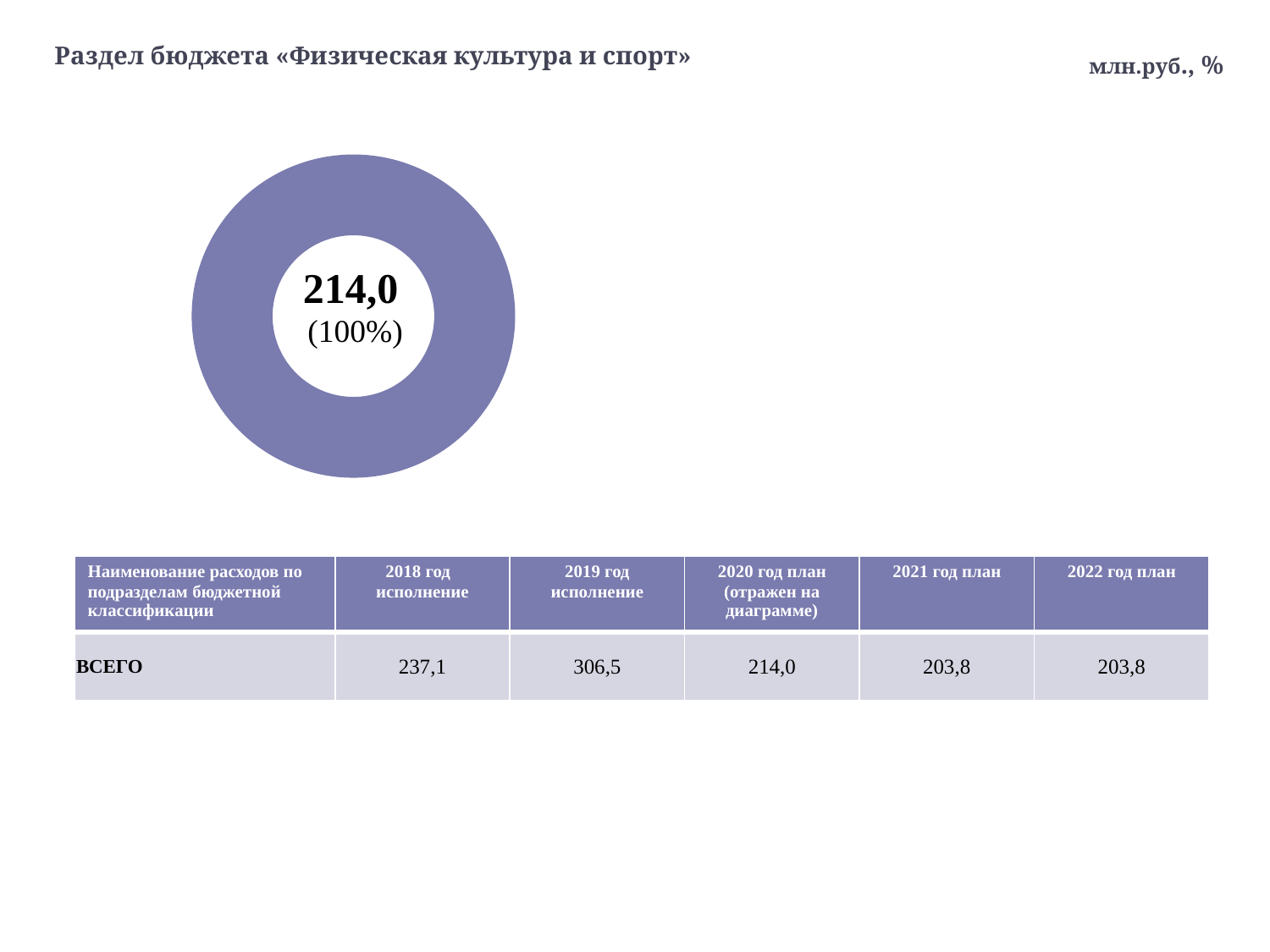
What kind of chart is shown on the slide? Pie chart (donut) What units are indicated for the chart in the top-right corner of the slide? млн.руб., % Which year's figure does the donut chart reflect, according to the table header? 2020 год план How many slices does the donut chart contain? 1 What value is printed in the centre of the donut chart? 214,0 What share of the donut chart does the single slice represent? 100%